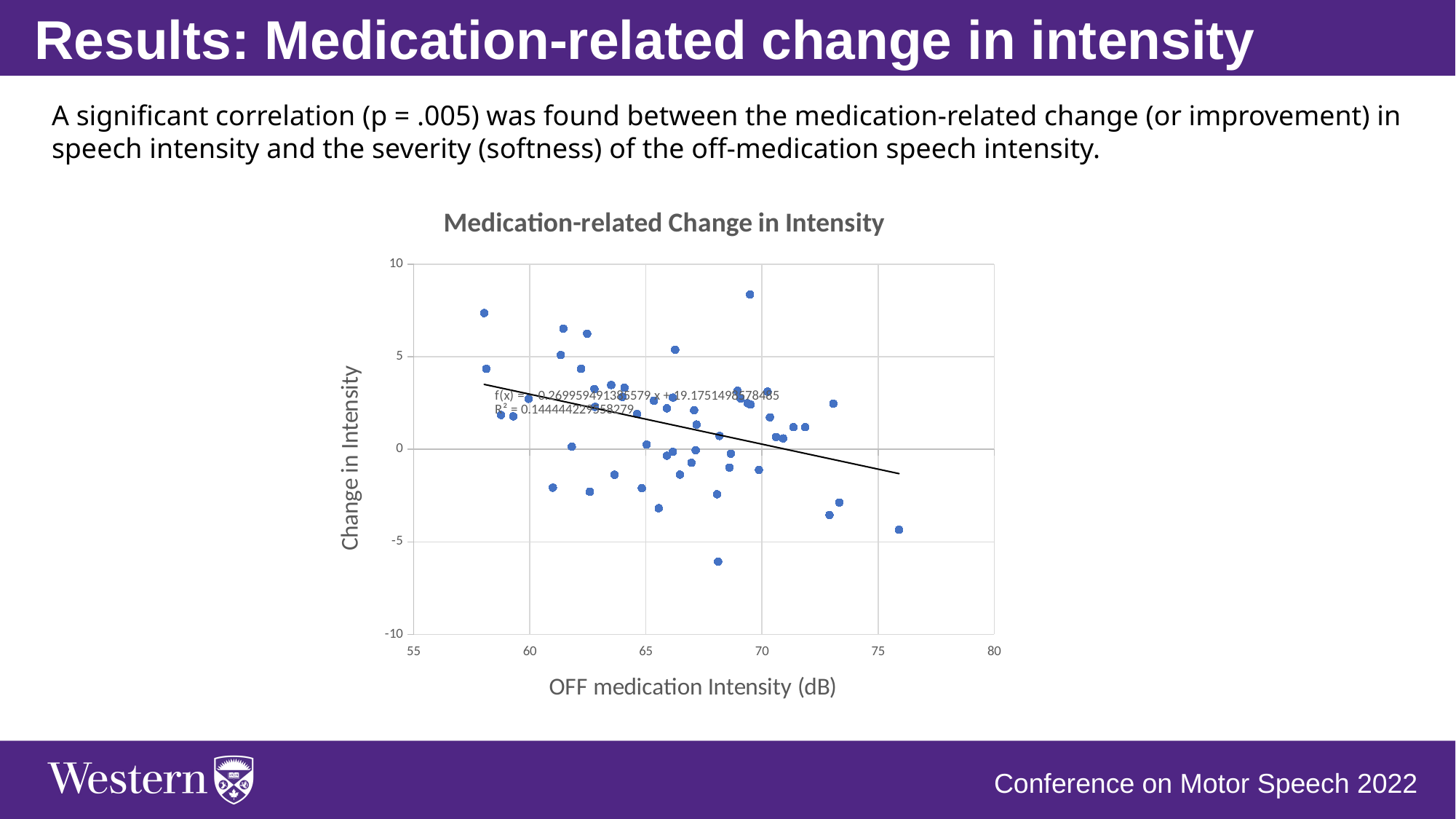
Does the trendline in the chart rise or fall as OFF medication intensity increases? Fall Is the change in intensity for the highest point on the chart greater or less than 5? greater Is the OFF medication intensity of the leftmost point on the chart greater or less than 60? less Is the change in intensity for the lowest point on the chart greater or less than -5? less Is the slope of the fitted trendline positive or negative? Negative What is the maximum value shown on the x axis of the chart? 80 What is the label of the x axis of the chart? OFF medication Intensity (dB) What kind of chart is shown on the slide? Scatter plot What is the title of the chart? Medication-related Change in Intensity